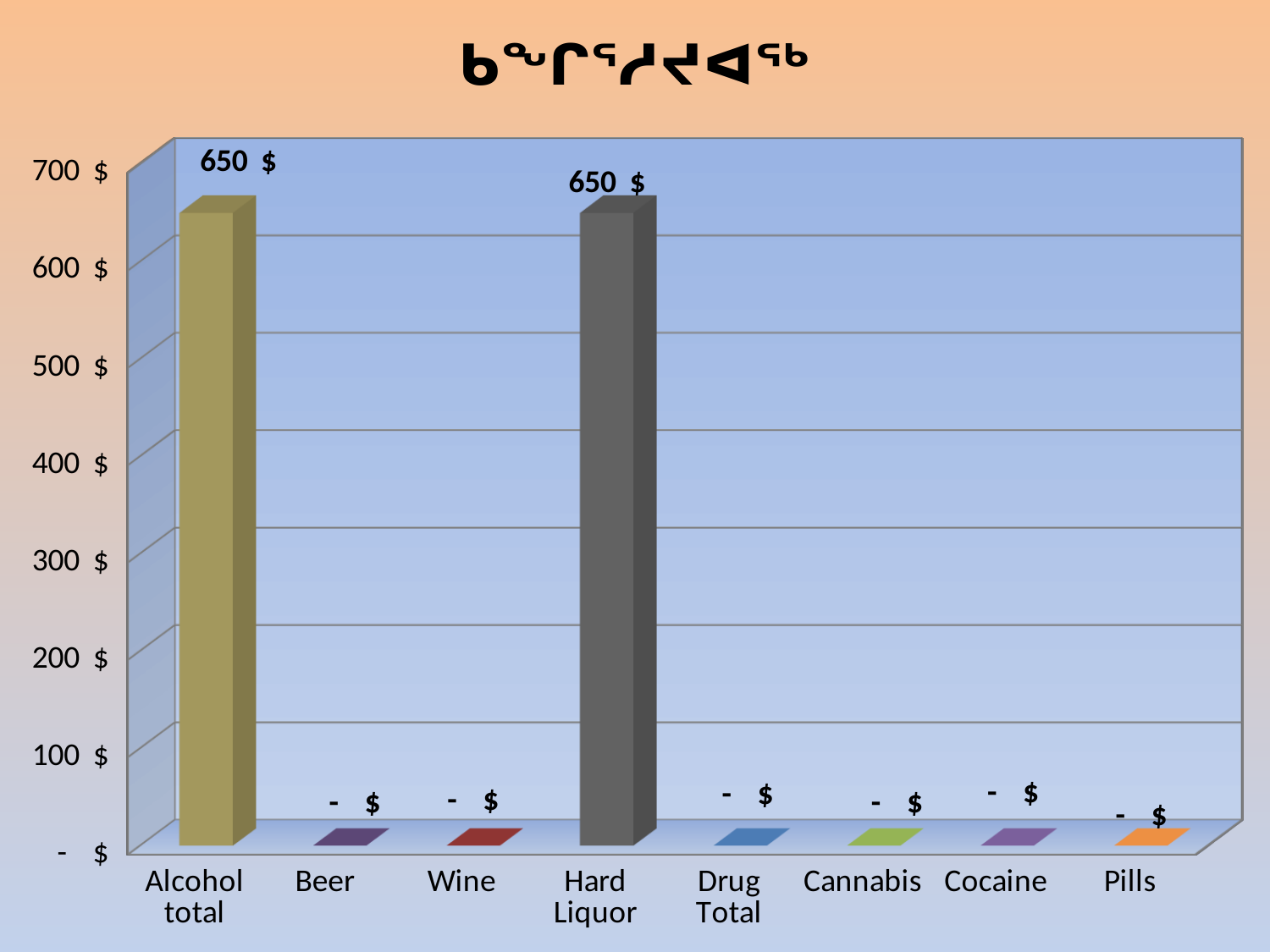
Which is larger, the value for Hard Liquor or the value for Wine? Hard Liquor What is the highest value shown on the vertical axis? 700 $ Is the value for Alcohol total greater or less than 600 $? greater Is the value for Hard Liquor greater or less than 700 $? less What is the difference between the value for Alcohol total and the value for Hard Liquor? 0 $ What is the value for Hard Liquor? 650 $ What is the data label shown for Beer? - $ What is the value for Alcohol total? 650 $ Which category has the highest value, Drug Total or Alcohol total? Alcohol total What is the data label shown for Cannabis? - $ What kind of chart is this? bar chart How many categories are shown on the x axis? 8